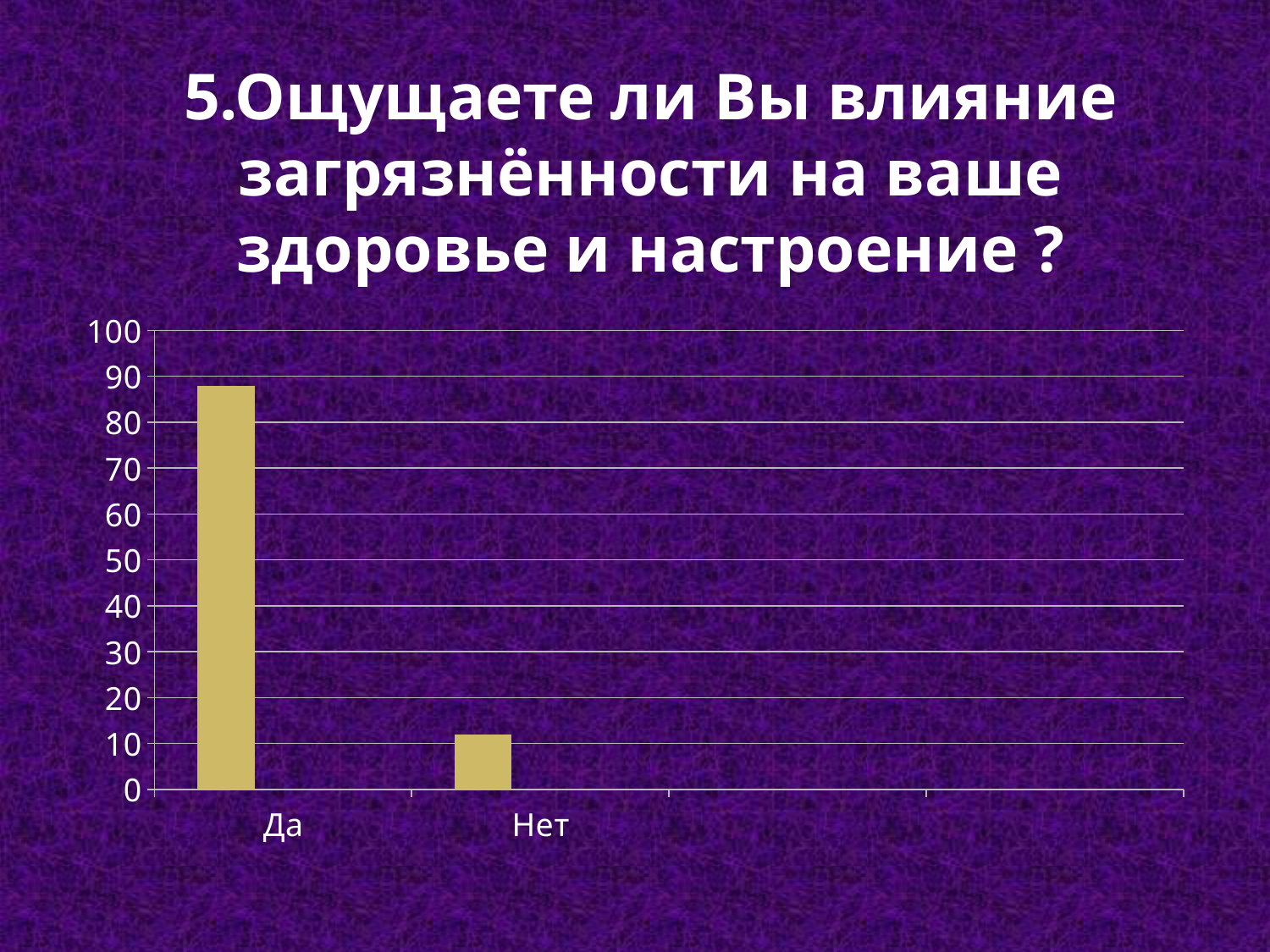
Which category has the lowest bar? Нет What is the title of the chart on the slide? 5.Ощущаете ли Вы влияние загрязнённости на ваше здоровье и настроение ? Is the value for Да greater or less than 50? greater What is the maximum value shown on the vertical axis of the chart? 100 Do the values rise or fall going from Да to Нет along the x axis? fall Is the value for Нет greater or less than 20? less Is the value for Нет greater or less than 30? less What kind of chart is shown on the slide? bar chart How many categories are shown on the x axis of the chart? 2 Which is larger, the value for Да or the value for Нет? Да Which category has the highest bar? Да